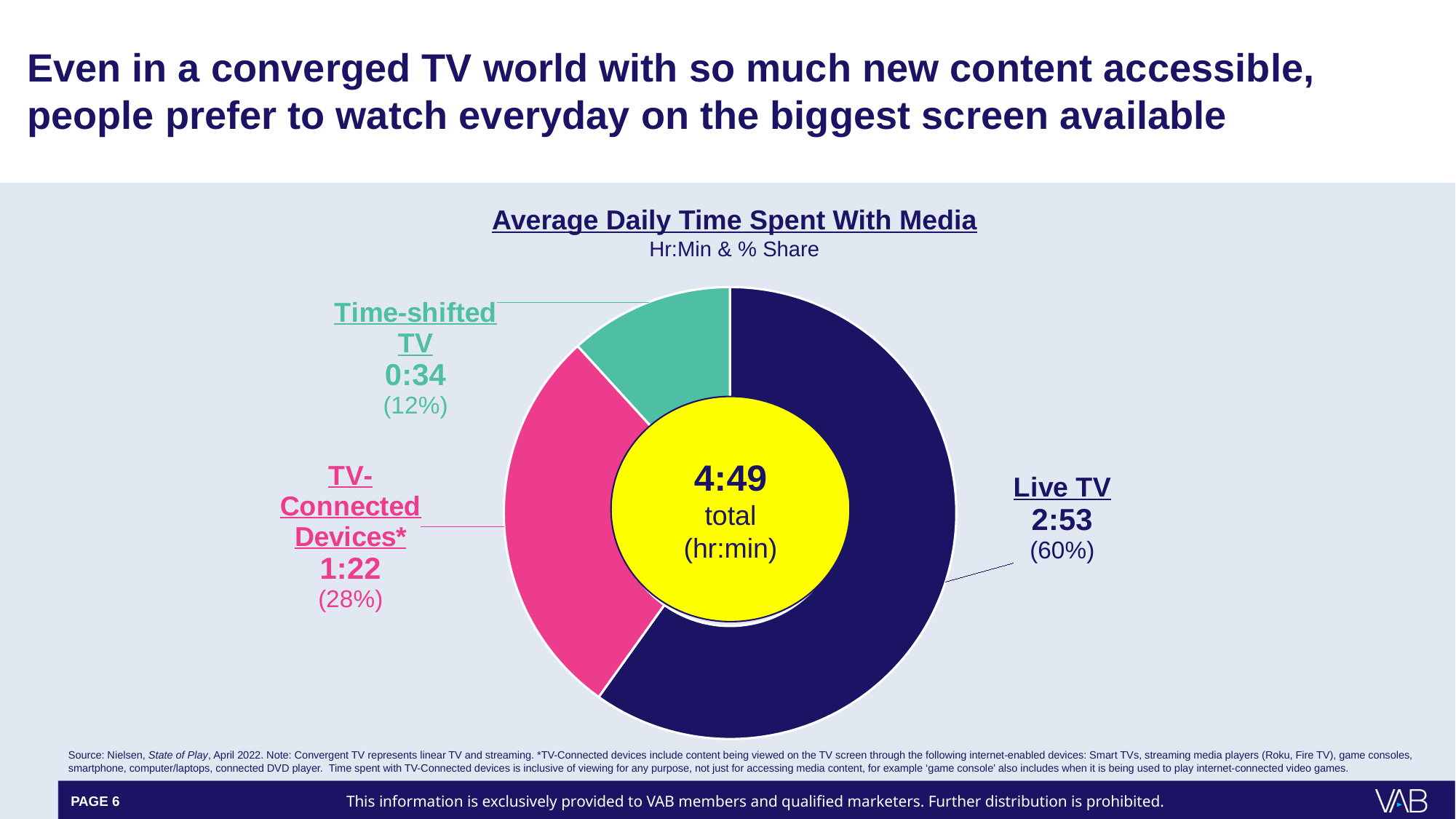
What is the total average daily time spent with media shown in the centre of the chart? 4:49 What percentage share of daily media time does TV-Connected Devices account for? 28% What is the average daily time spent with Time-shifted TV? 0:34 Which is larger, the time spent with TV-Connected Devices or with Time-shifted TV? TV-Connected Devices Which category has the largest share of average daily time spent with media? Live TV Which category has the smallest share of average daily time spent with media? Time-shifted TV What percentage share of daily media time does Live TV account for? 60% How many percentage points larger is the Live TV share than the TV-Connected Devices share? 32 percentage points What kind of chart is used to show Average Daily Time Spent With Media? Pie chart (doughnut) What is the average daily time spent with TV-Connected Devices? 1:22 How many categories are shown in the chart? 3 What is the average daily time spent with Live TV? 2:53